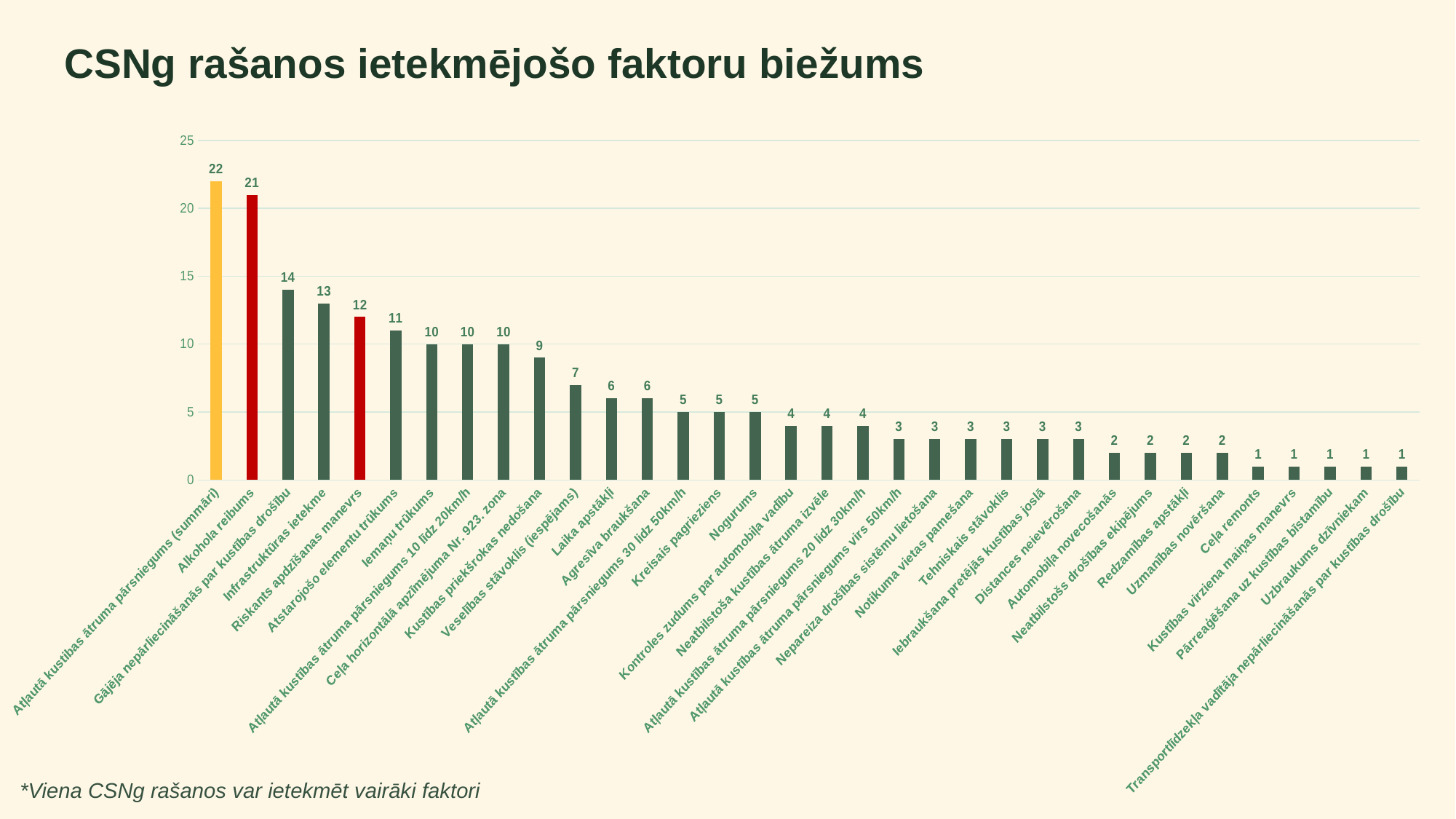
How many categories are shown on the x axis? 34 What is the value for Kustības priekšrokas nedošana? 9 What is the title of the chart? CSNg rašanos ietekmējošo faktoru biežums Which is larger, the value for Atstarojošo elementu trūkums or the value for Veselības stāvoklis (iespējams)? Atstarojošo elementu trūkums Do the values rise or fall from left to right along the x axis? Fall Which category has the highest value? Atļautā kustības ātruma pārsniegums (summāri) What kind of chart is shown on the slide? Bar chart What is the difference between the values for Atļautā kustības ātruma pārsniegums (summāri) and Alkohola reibums? 1 What is the value for Nogurums? 5 What is the difference between the values for Gājēja nepārliecināšanās par kustības drošību and Riskants apdzīšanas manevrs? 2 What is the value for Alkohola reibums? 21 What is the value for Infrastruktūras ietekme? 13